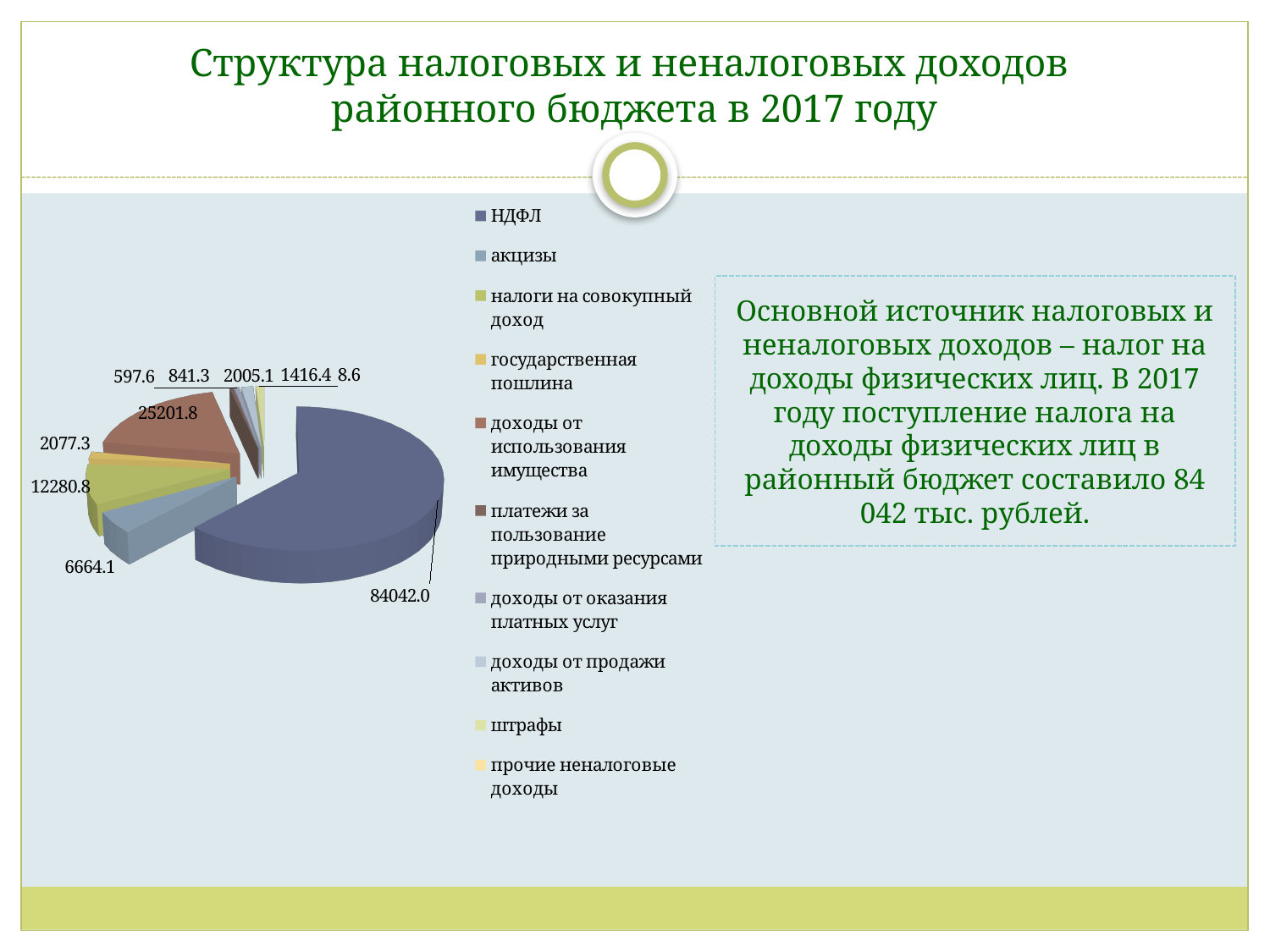
How many categories does the legend of the pie chart list? 10 What is the value shown for налоги на совокупный доход? 12280.8 What is the value shown for НДФЛ? 84042.0 What is the title of the slide containing the pie chart? Структура налоговых и неналоговых доходов районного бюджета в 2017 году Which is larger, the value for акцизы or the value for налоги на совокупный доход? налоги на совокупный доход What type of chart is shown on the slide? pie chart Which category has the largest slice of the pie? НДФЛ What is the value shown for доходы от использования имущества? 25201.8 What is the difference between the values for НДФЛ and доходы от использования имущества? 58840.2 Which category has the smallest value in the pie chart? прочие неналоговые доходы What is the value shown for государственная пошлина? 2077.3 What is the value shown for акцизы? 6664.1